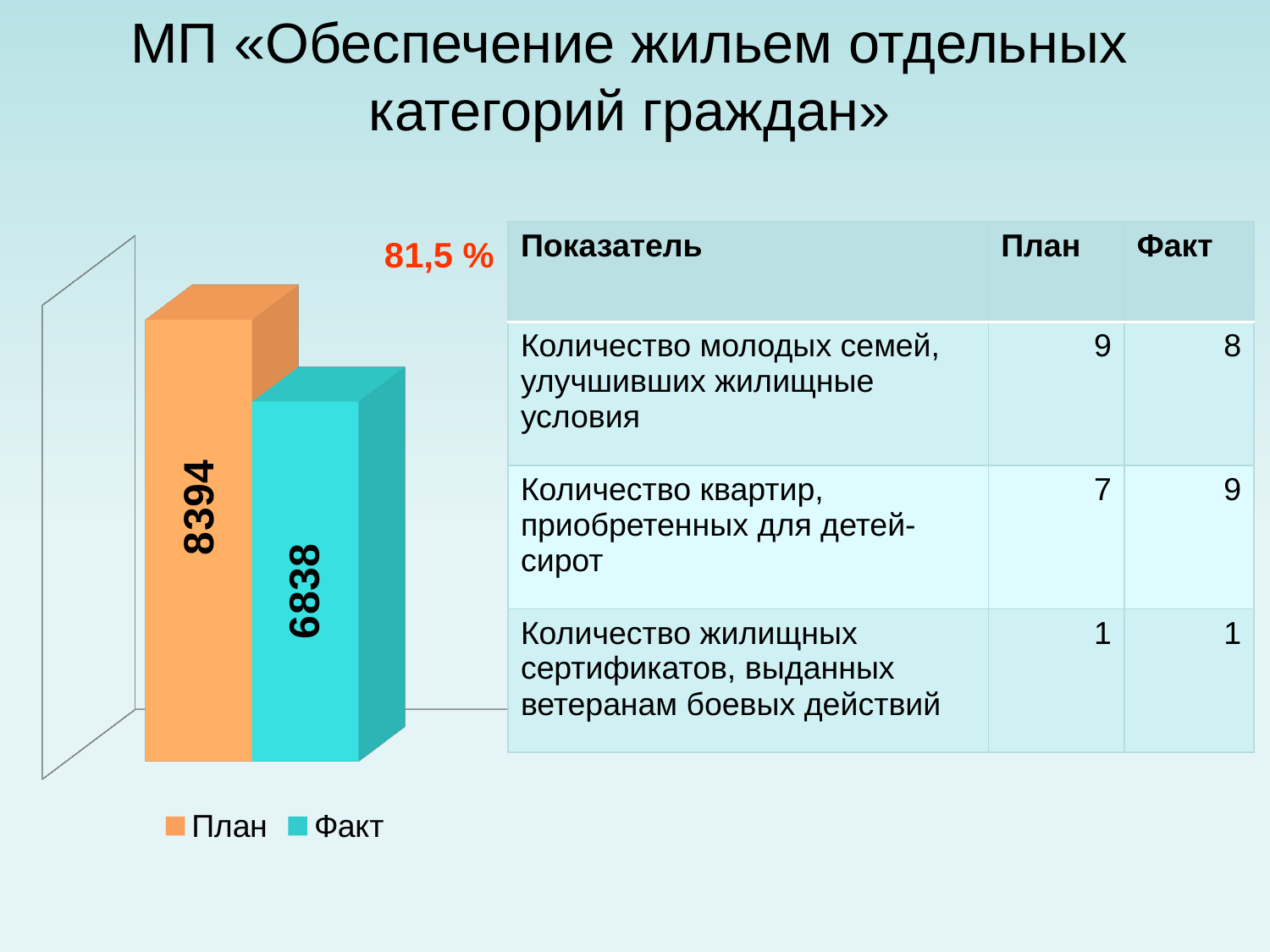
How many bars are plotted in the chart? 2 Which bar in the chart is the highest? План What is the difference between the План and Факт values in the chart? 1556 Which series has the higher bar in the chart, План or Факт? План What is the value of the Факт bar in the chart? 6838 What kind of chart is shown on the slide? Bar chart What percentage is printed in red above the chart? 81,5 % What colour is the Факт bar in the chart? Turquoise Which bar in the chart is the lowest? Факт What is the value of the План bar in the chart? 8394 How many series does the chart legend list? 2